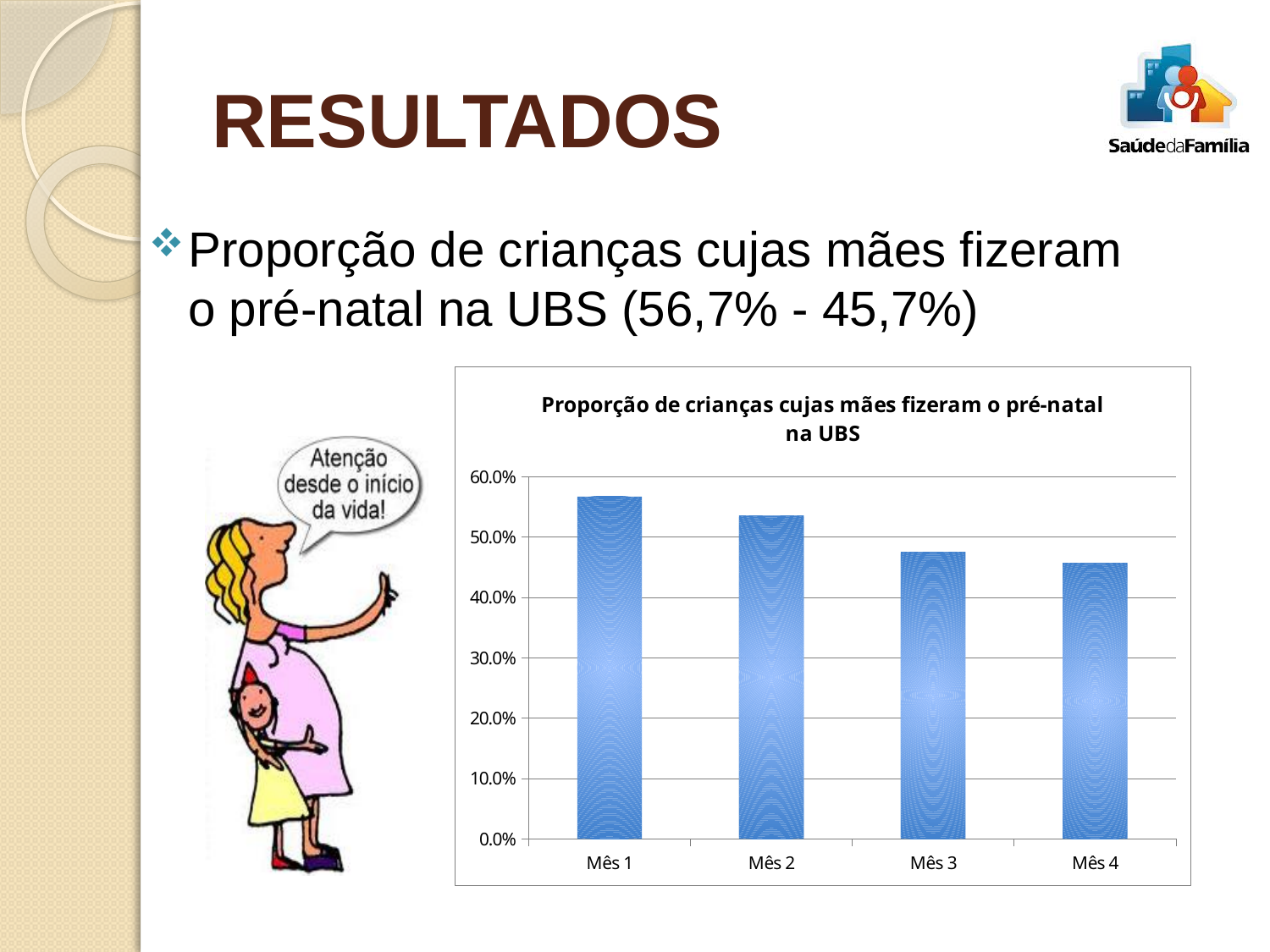
Is the value for Mês 3 greater or less than 50.0%? less What kind of chart is shown on the slide? bar chart What is the highest value shown on the chart's y axis? 60.0% Do the values rise or fall from Mês 1 to Mês 4? fall What is the title of the chart? Proporção de crianças cujas mães fizeram o pré-natal na UBS How many months (categories) are plotted on the x axis of the chart? 4 Is the value for Mês 1 greater or less than 50.0%? greater Which month has the highest bar in the chart? Mês 1 Is the value for Mês 4 greater or less than 40.0%? greater Which is larger, the value for Mês 2 or the value for Mês 3? Mês 2 Which month has the lowest bar in the chart? Mês 4